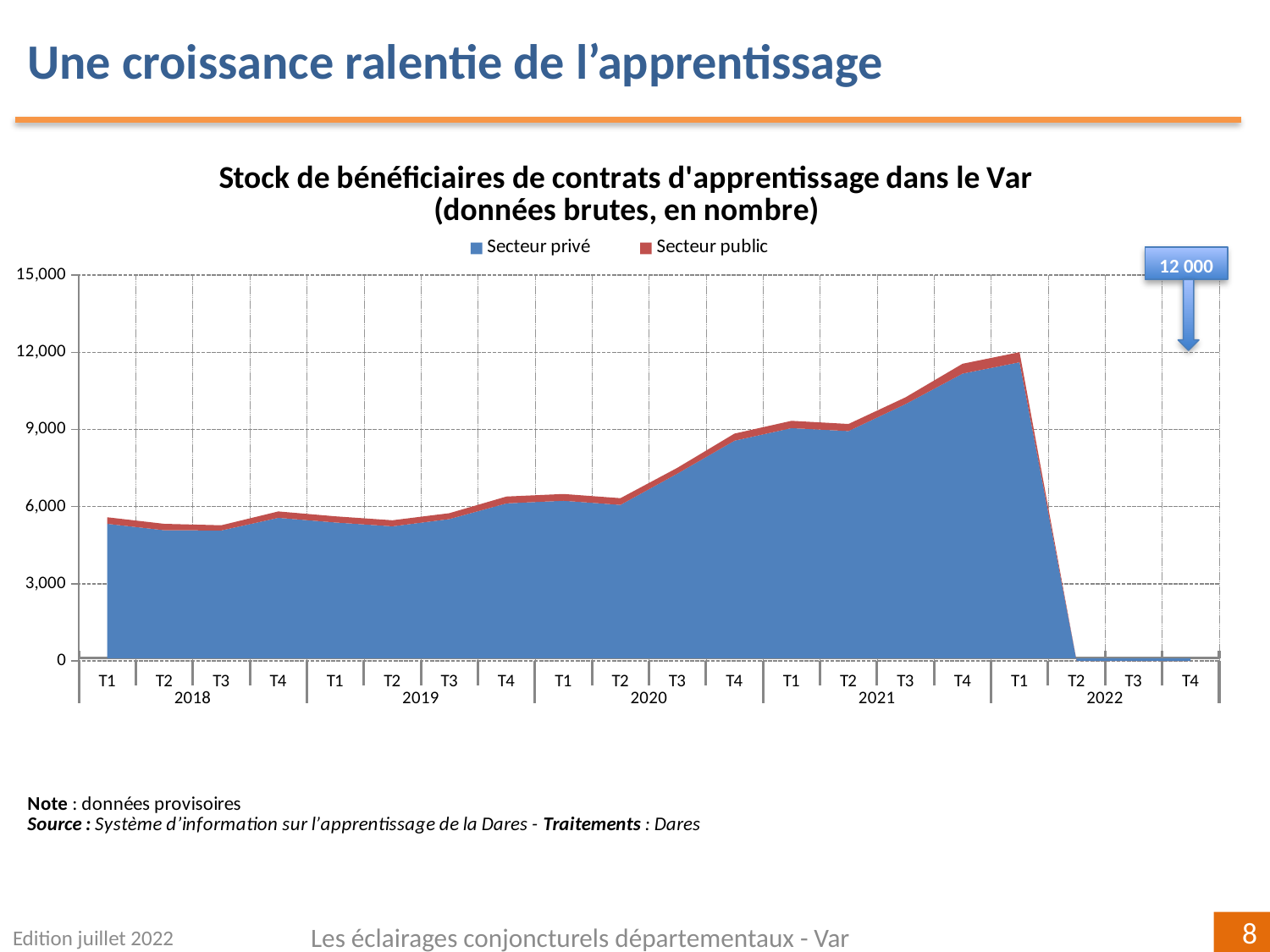
Is the total value for T4 2020 greater or less than 6,000? greater How many series does the legend list? 2 Which is larger, the total for T4 2019 or the total for T4 2020? T4 2020 Does the total stock rise or fall from T1 2018 to T1 2021? Rise How many quarters are shown on the x axis? 20 Which quarter has the highest total stock of apprenticeship contracts? T1 2022 Which colour represents Secteur privé? Blue What kind of chart is shown on the slide? Area chart Is the total value for T1 2018 greater or less than 6,000? less Is the total value for T4 2021 greater or less than 9,000? greater Which two series are listed in the legend? Secteur privé and Secteur public